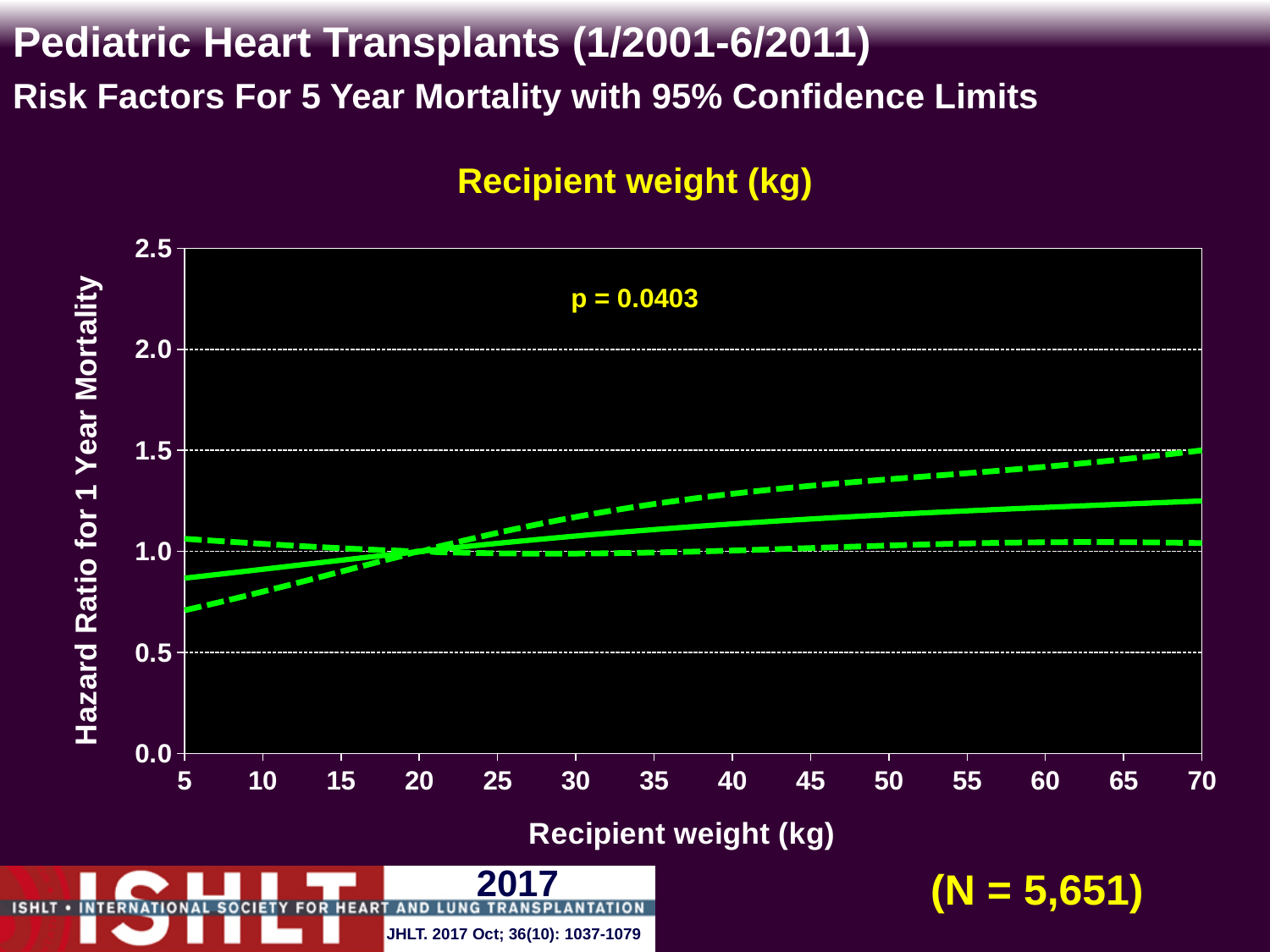
Is the lower dashed confidence limit at a recipient weight of 5 kg greater or less than 1.0? less Is the upper dashed confidence limit at a recipient weight of 40 kg greater or less than 1.0? greater How many tick marks are labelled on the x axis (recipient weight)? 14 What is the p-value printed on the chart? p = 0.0403 Is the upper dashed confidence limit at a recipient weight of 40 kg greater or less than 1.5? less What is the highest value labelled on the y axis? 2.5 Does the solid hazard ratio line rise or fall as recipient weight increases from 5 kg to 70 kg? rise What kind of chart is shown on the slide? line chart What is the sample size (N) shown on the slide? N = 5,651